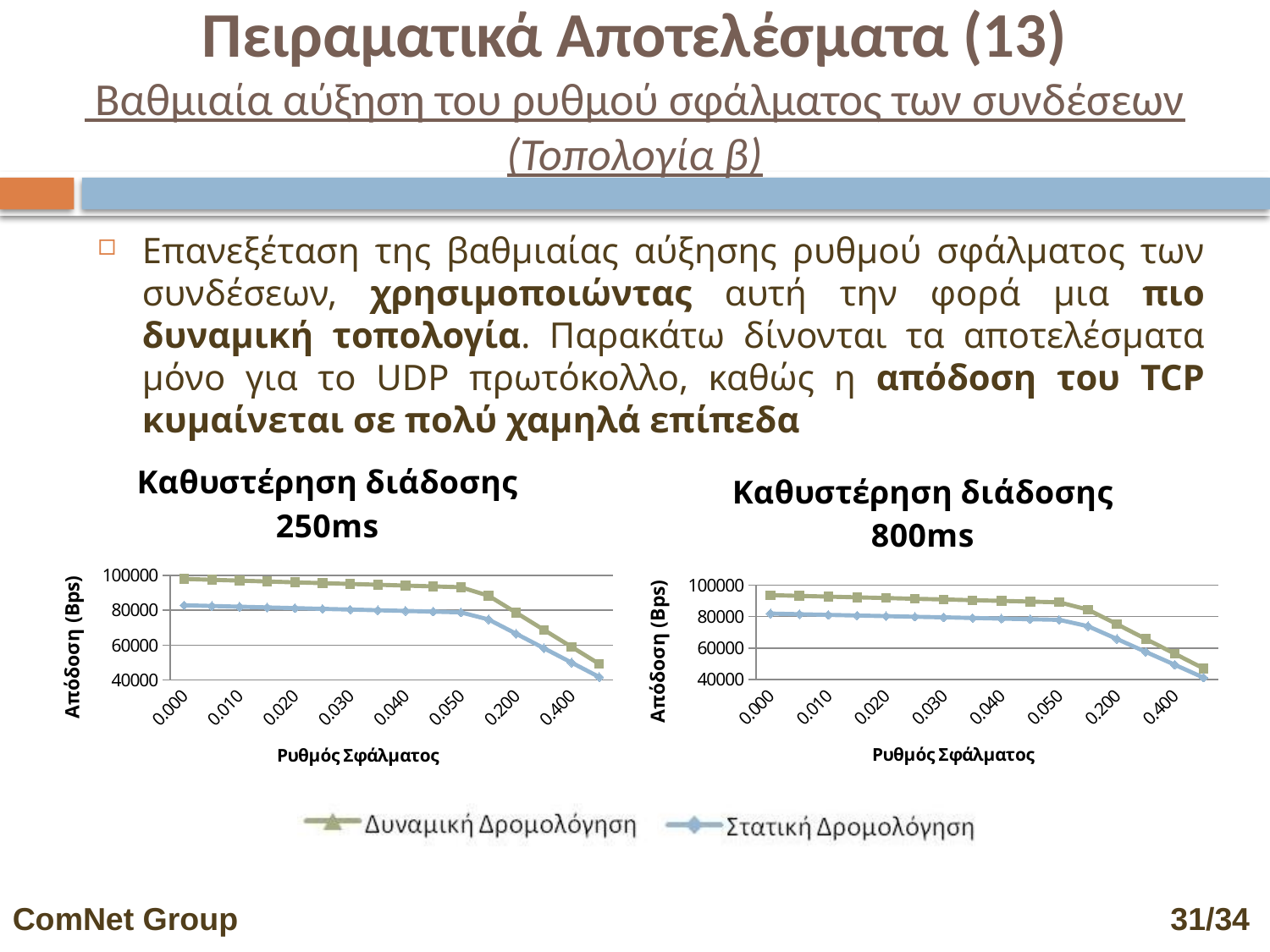
How many series does the legend list for the charts on the slide? 2 How many error rate values are labelled on the x axis of the right chart (800ms)? 8 What are the two series named in the legend? Δυναμική Δρομολόγηση and Στατική Δρομολόγηση In the left chart (250ms), is the value of Δυναμική Δρομολόγηση at error rate 0.000 greater or less than 80000? greater What is the label of the y axis on the left chart (250ms)? Απόδοση (Bps) In the right chart (800ms), does the Δυναμική Δρομολόγηση series rise or fall as the error rate increases? Fall In the left chart (250ms), is the value of Στατική Δρομολόγηση at error rate 0.000 greater or less than 60000? greater In the right chart (800ms), is the value of Στατική Δρομολόγηση at error rate 0.400 greater or less than 80000? less What kind of chart is the left chart titled 'Καθυστέρηση διάδοσης 250ms'? Line chart In the left chart (250ms), which series has the higher value at error rate 0.000, Δυναμική Δρομολόγηση or Στατική Δρομολόγηση? Δυναμική Δρομολόγηση In the left chart (250ms), does the throughput (Απόδοση) rise or fall as the error rate (Ρυθμός Σφάλματος) increases along the x axis? Fall